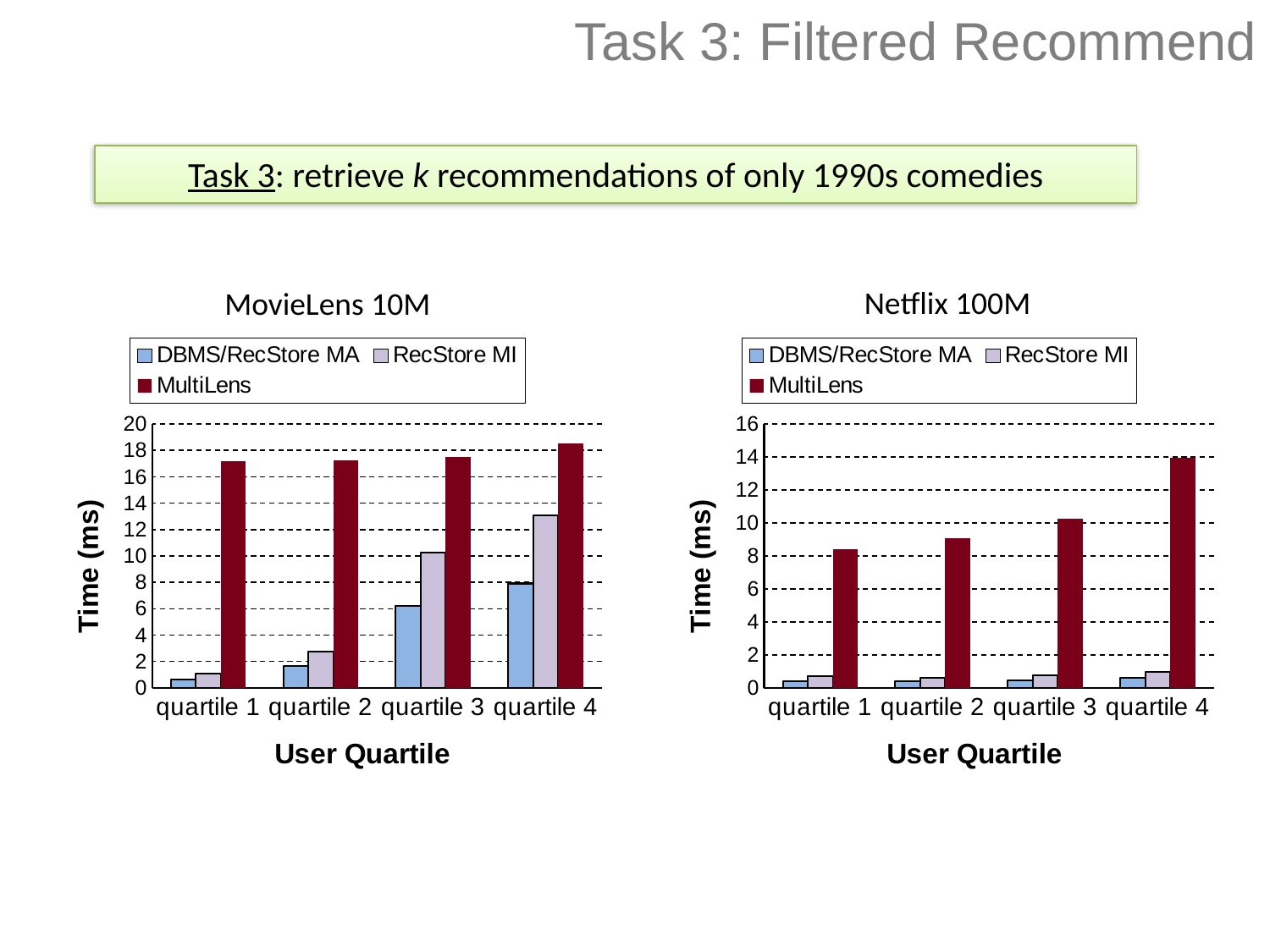
In the Netflix 100M chart, which quartile has the highest MultiLens value? quartile 4 How many user quartile categories are shown on the x axis of the MovieLens 10M chart? 4 In the Netflix 100M chart, is the MultiLens value for quartile 4 greater or less than 12? greater What is the y-axis title of the Netflix 100M chart? Time (ms) In the MovieLens 10M chart, is the RecStore MI value for quartile 3 greater or less than 8? greater What kind of chart is the MovieLens 10M chart? bar chart How many series does the legend of the Netflix 100M chart list? 3 In the Netflix 100M chart, which quartile has the lowest MultiLens value? quartile 1 In the Netflix 100M chart, do the MultiLens values rise or fall from quartile 1 to quartile 4? rise In the MovieLens 10M chart, which is larger at quartile 3: RecStore MI or DBMS/RecStore MA? RecStore MI In the MovieLens 10M chart, is the MultiLens value for quartile 4 greater or less than 16? greater In the MovieLens 10M chart, which quartile has the highest RecStore MI value? quartile 4